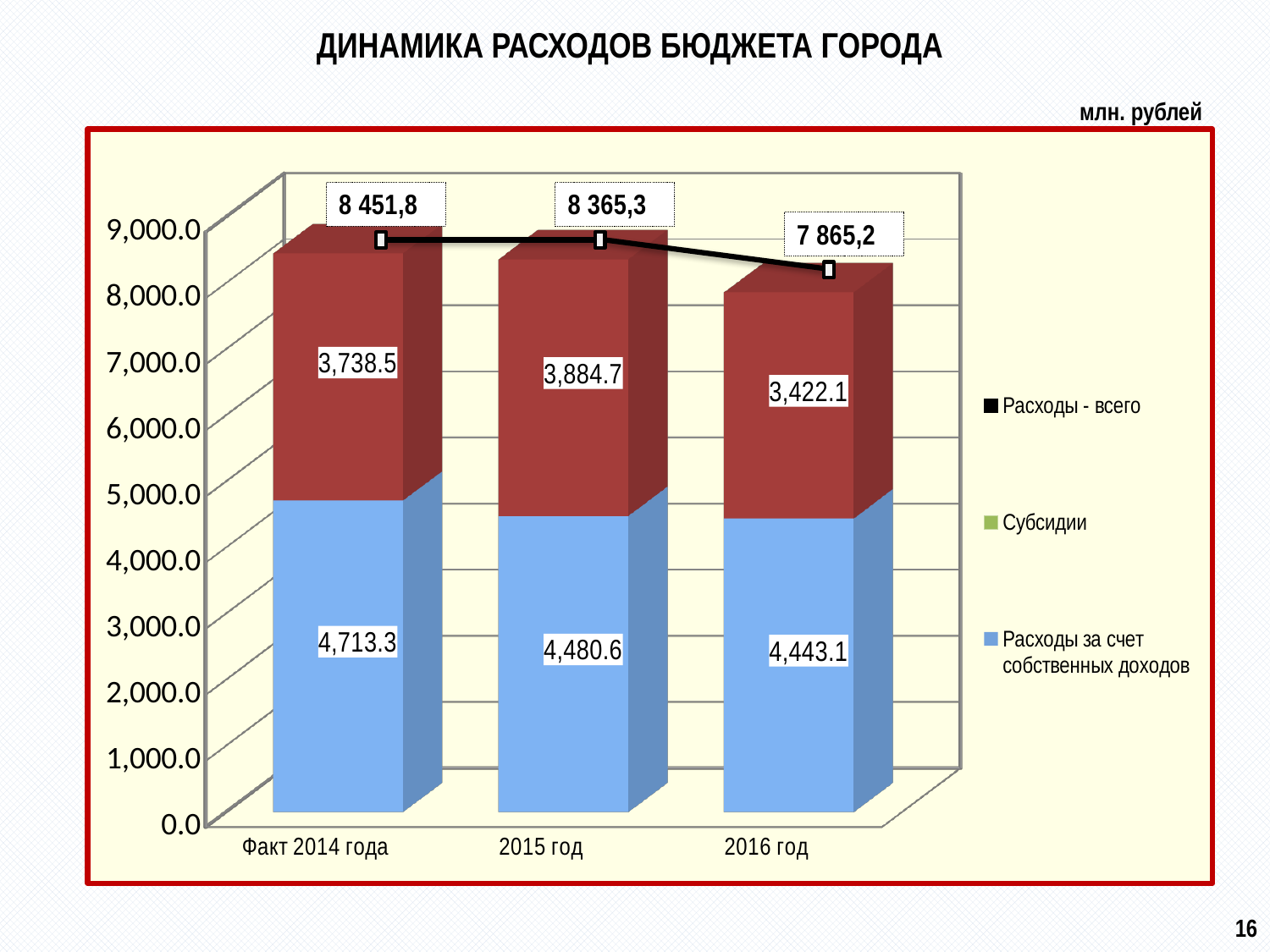
Which category has the lowest value for the upper (red) segment? 2016 год What is the value of the lower (blue) segment for 2016 год? 4,443.1 Which category has the highest total expenditure (Расходы - всего)? Факт 2014 года How many categories are shown on the x axis? 3 Does the total expenditure (Расходы - всего) rise or fall from Факт 2014 года to 2016 год? Fall What is the value of the lower (blue) segment, Расходы за счет собственных доходов, for Факт 2014 года? 4,713.3 What is the value of the upper (red) segment of the bar for 2015 год? 3,884.7 What is the difference between the lower (blue) segment values for Факт 2014 года and 2015 год? 232.7 What is the total expenditure (Расходы - всего) shown for 2016 год? 7 865,2 How many series does the legend list? 3 Which is larger: the upper (red) segment for 2015 год or for Факт 2014 года? 2015 год What kind of chart is this? Stacked bar chart with a line